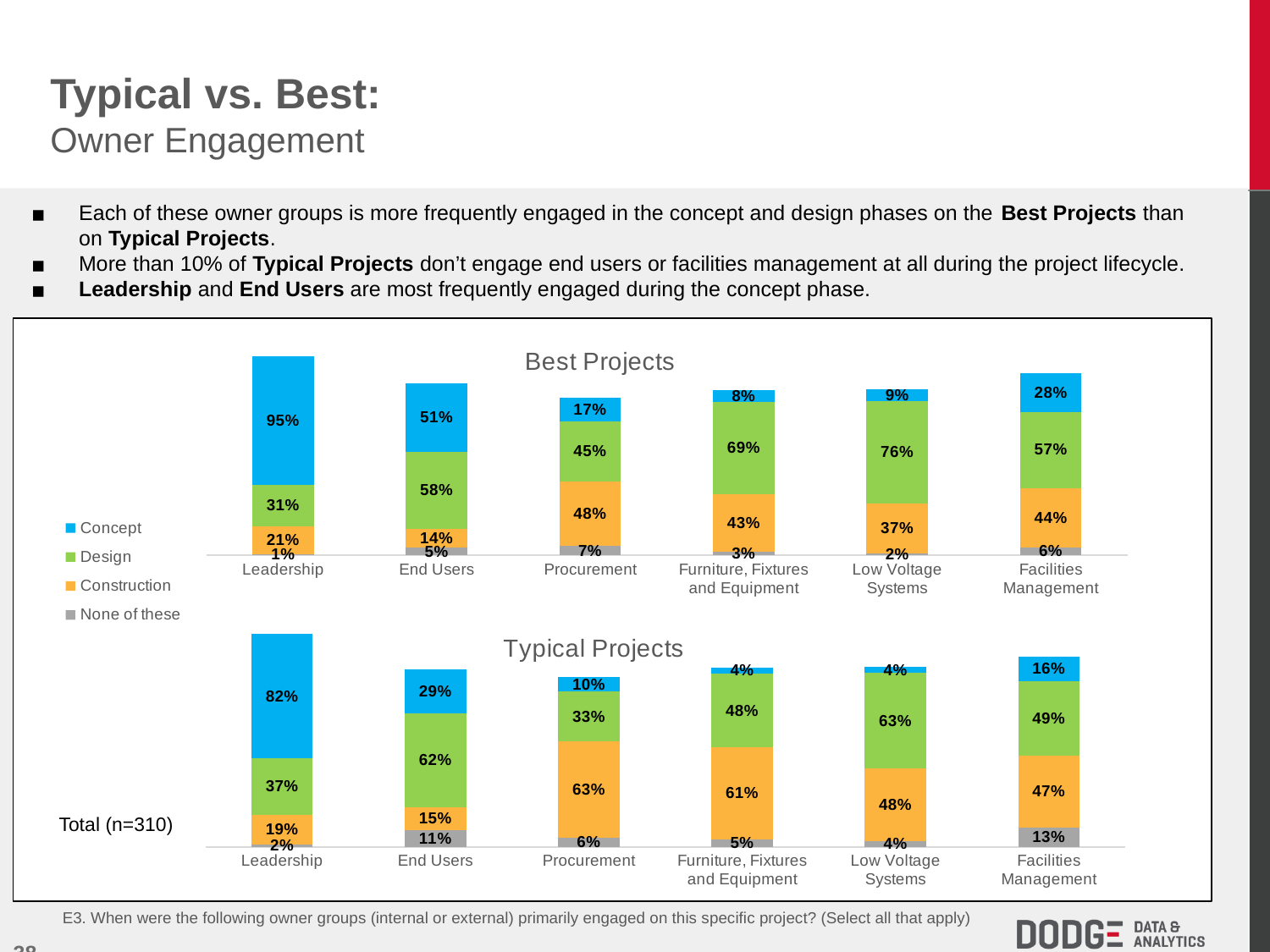
What is the difference between the Concept value for Leadership in the Best Projects chart and in the Typical Projects chart? 13 percentage points In the Best Projects chart, is the Construction value for Procurement larger or smaller than the Design value for Procurement? larger In the Best Projects chart, which owner group has the highest Design value? Low Voltage Systems In the Typical Projects chart, what is the None of these value for Facilities Management? 13% What type of chart is the Best Projects chart? stacked bar chart In the Typical Projects chart, what is the Construction value for Procurement? 63% How many owner groups are shown on the x axis of the Typical Projects chart? 6 In the Typical Projects chart, what is the Design value for End Users? 62% In the Best Projects chart, what is the Concept value for Leadership? 95% In the Typical Projects chart, which owner group has the lowest Concept value? Furniture, Fixtures and Equipment and Low Voltage Systems (both 4%) Which colour represents the Concept series in the legend? blue How many series does the legend list? 4